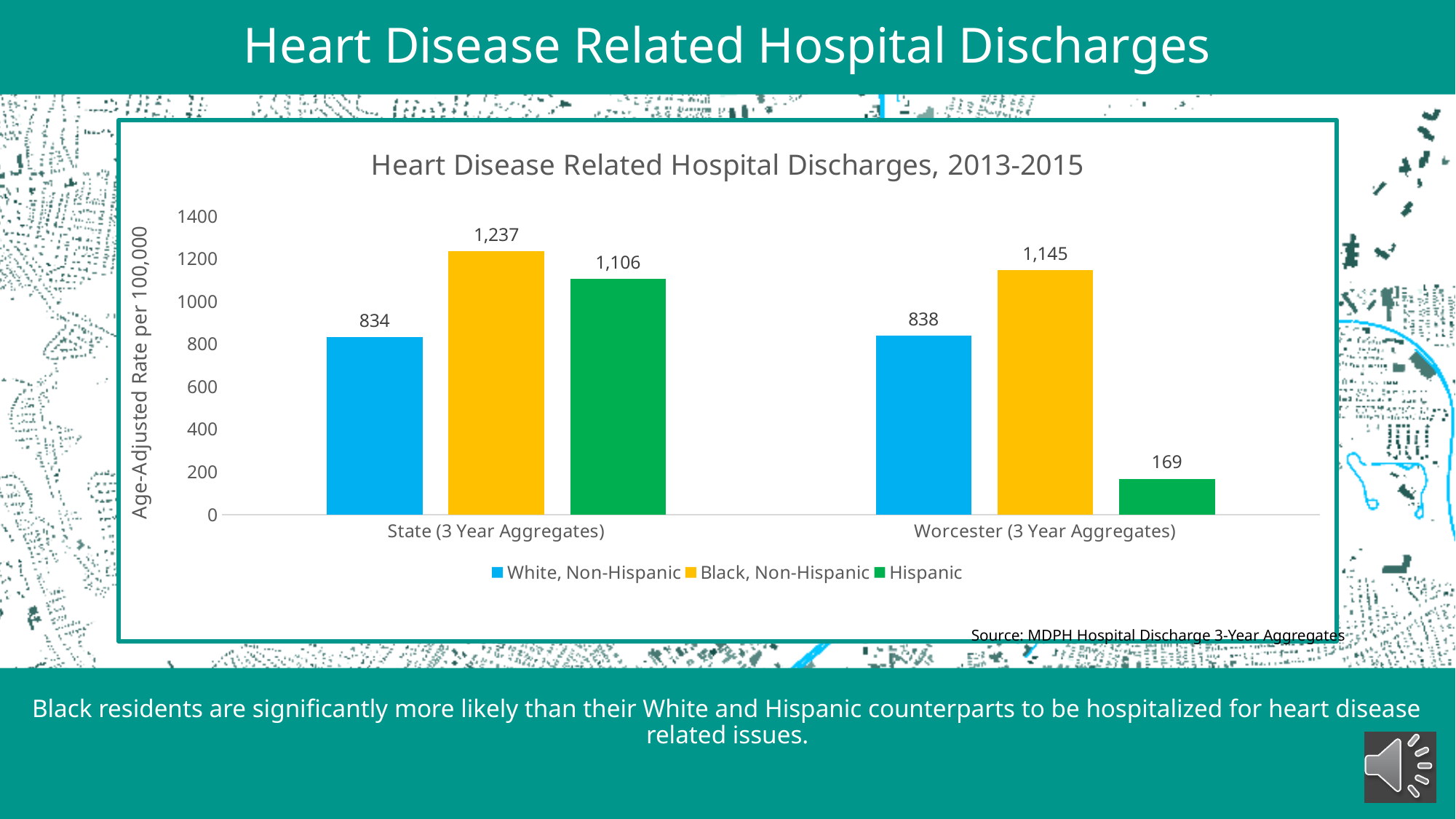
How many series does the legend list? 3 Which group has the highest rate in the State (3 Year Aggregates) category? Black, Non-Hispanic Which group has the lowest rate in Worcester (3 Year Aggregates)? Hispanic What is the age-adjusted rate for White, Non-Hispanic residents in the State (3 Year Aggregates) group? 834 What is the label of the vertical axis? Age-Adjusted Rate per 100,000 What kind of chart is shown on the slide? Bar chart Is the Hispanic rate for the State (3 Year Aggregates) greater or less than 1000? greater What is the age-adjusted rate for Hispanic residents in Worcester (3 Year Aggregates)? 169 What is the age-adjusted rate for Black, Non-Hispanic residents in Worcester (3 Year Aggregates)? 1,145 What is the difference between the Hispanic rate for the State and the Hispanic rate for Worcester? 937 What is the difference between the Black, Non-Hispanic rate and the White, Non-Hispanic rate in the State (3 Year Aggregates) group? 403 Which is larger: the Black, Non-Hispanic rate for the State or for Worcester? State (3 Year Aggregates)